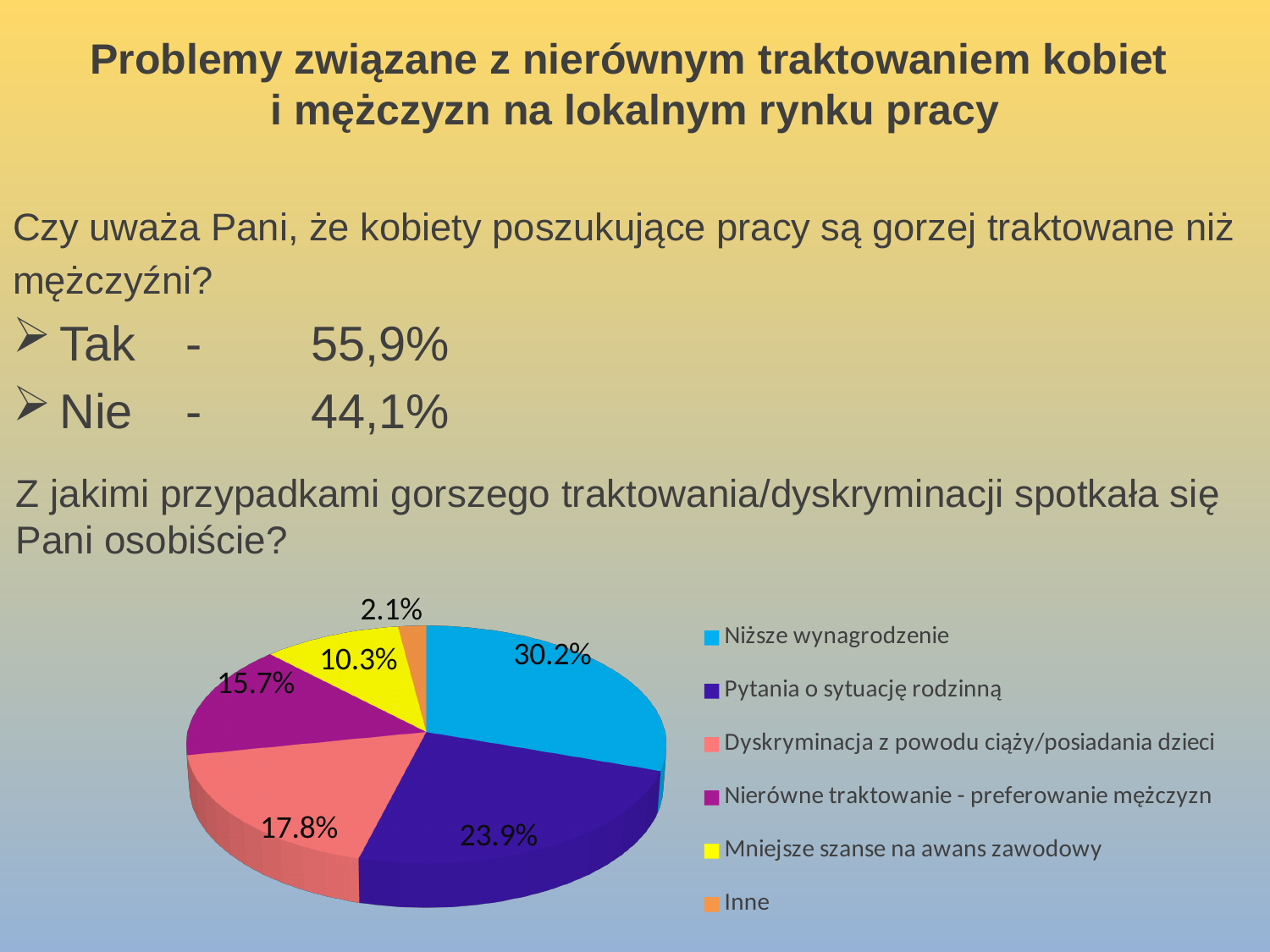
What share of the pie does "Niższe wynagrodzenie" have? 30.2% Which category has the largest slice of the pie? Niższe wynagrodzenie What is the value shown for "Nierówne traktowanie - preferowanie mężczyzn"? 15.7% What is the value shown for "Pytania o sytuację rodzinną"? 23.9% Which is larger: "Dyskryminacja z powodu ciąży/posiadania dzieci" or "Mniejsze szanse na awans zawodowy"? Dyskryminacja z powodu ciąży/posiadania dzieci What type of chart is shown on the slide? pie chart What is the value shown for "Mniejsze szanse na awans zawodowy"? 10.3% How many categories does the pie chart have? 6 What is the value shown for "Inne"? 2.1% What is the difference between the values for "Niższe wynagrodzenie" and "Pytania o sytuację rodzinną"? 6.3% Which category has the smallest slice of the pie? Inne What is the value shown for "Dyskryminacja z powodu ciąży/posiadania dzieci"? 17.8%